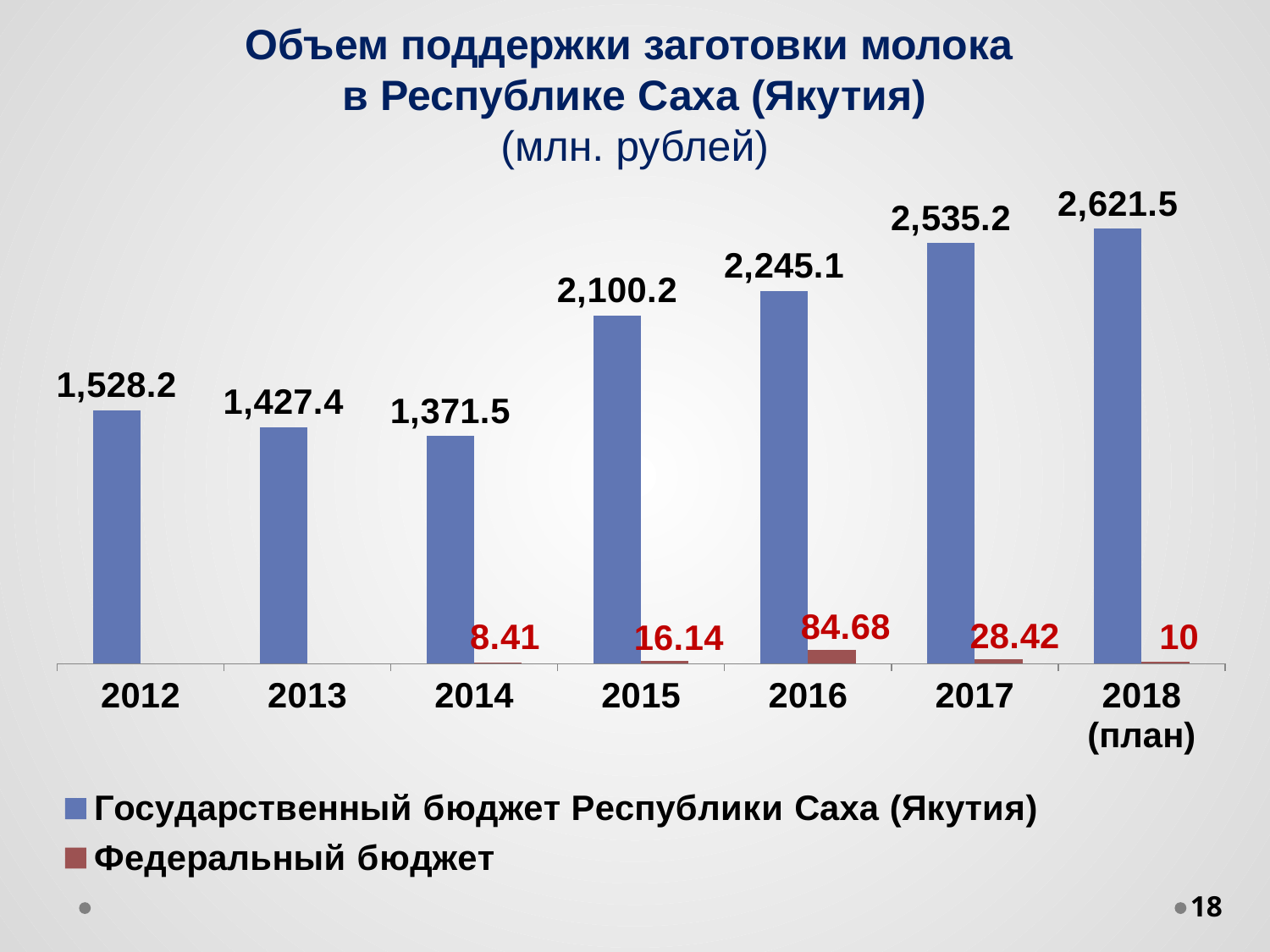
What is the value for Государственный бюджет Республики Саха (Якутия) in 2018 (план)? 2,621.5 How many series does the legend list? 2 How many years are shown on the x axis? 7 What kind of chart is shown on the slide? Bar chart Which is larger, the Федеральный бюджет value for 2015 or for 2017? 2017 What is the value for Государственный бюджет Республики Саха (Якутия) in 2012? 1,528.2 What is the value for Федеральный бюджет in 2016? 84.68 What is the difference between the Государственный бюджет Республики Саха (Якутия) values for 2017 and 2016? 290.1 Which year has the highest value for Государственный бюджет Республики Саха (Якутия)? 2018 (план) What unit is given in the chart title? млн. рублей Which year has the lowest value for Государственный бюджет Республики Саха (Якутия)? 2014 Which year has the highest value for Федеральный бюджет? 2016